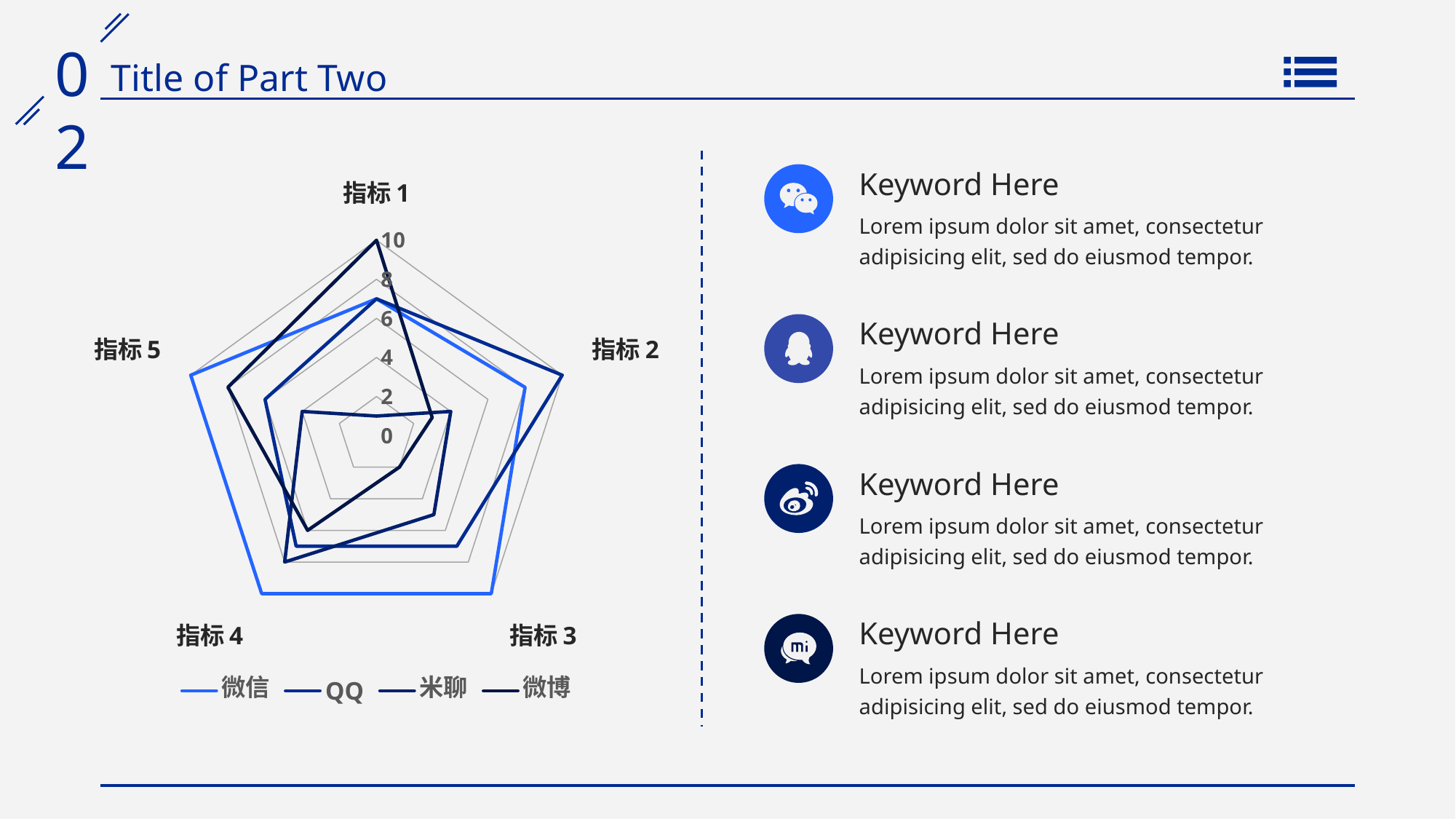
What kind of chart is shown on the slide? Radar chart Which series has the lowest value at 指标 1? 米聊 What is the maximum value shown on the radar chart's axis scale? 10 Which series has the highest value at 指标 1? 微博 How many categories (axes) does the radar chart have? 5 How many series does the legend of the radar chart list? 4 At 指标 5, which series has the larger value, 微信 or QQ? 微信 At 指标 4, which series has the larger value, 微信 or 米聊? 微信 What are the series names listed in the legend of the radar chart? 微信, QQ, 米聊, 微博 Is the value of 米聊 at 指标 1 greater or less than 4? less Is the value of 微信 at 指标 3 greater or less than 8? greater Is the value of 微博 at 指标 1 greater or less than 8? greater